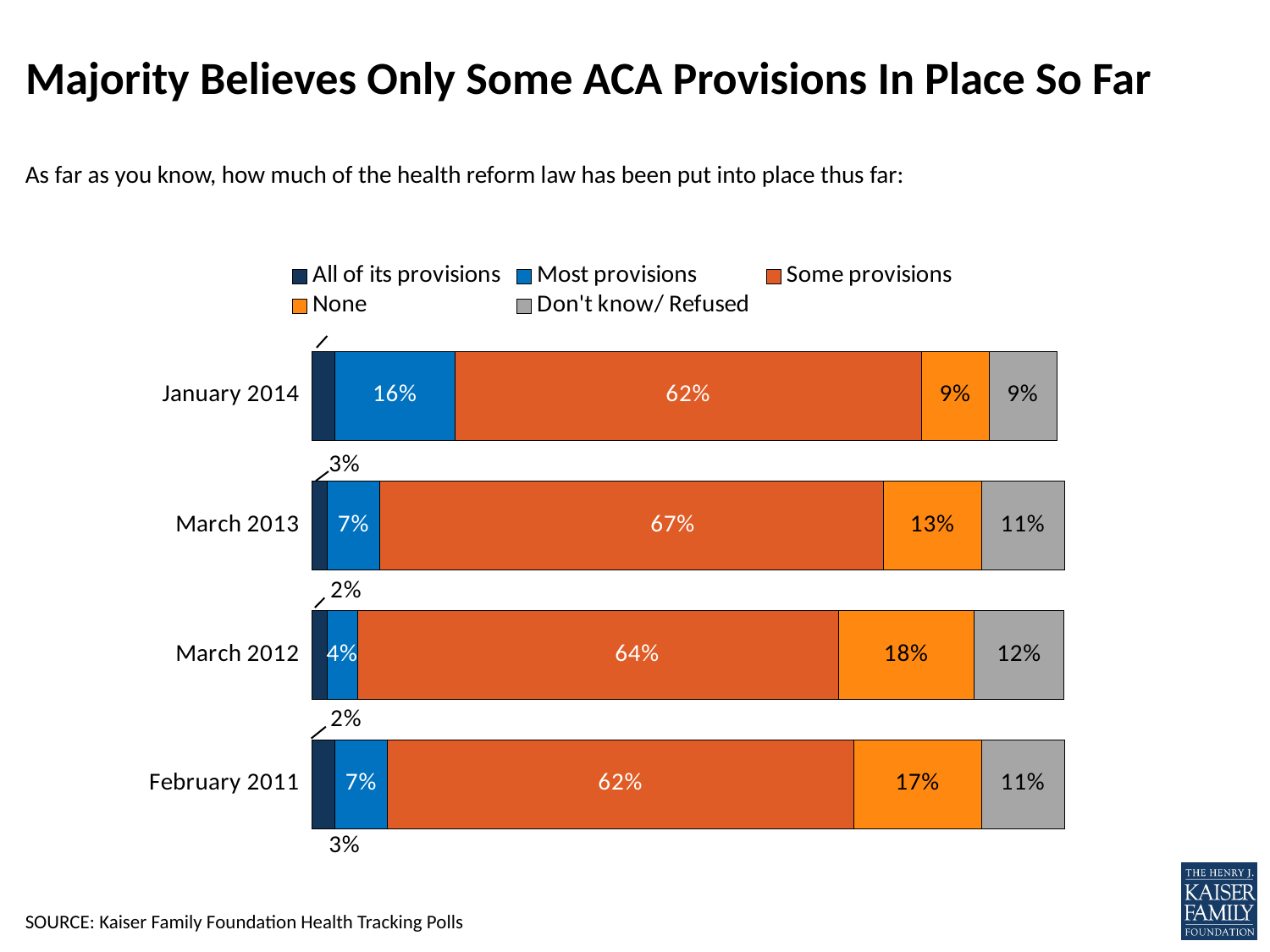
What is the "Don't know/ Refused" value for March 2013? 11% How many survey dates are shown on the chart? 4 What is the title of the slide? Majority Believes Only Some ACA Provisions In Place So Far What percentage said "None" in March 2012? 18% What kind of chart is shown on the slide? Stacked bar chart In which survey date was the "Some provisions" share highest? March 2013 How many series does the legend list? 5 How much larger is the "Most provisions" share in January 2014 than in February 2011? 9 percentage points What percentage said "Most provisions" in January 2014? 16% Which has a larger "None" share, March 2012 or March 2013? March 2012 What percentage said "Some provisions" in January 2014? 62% In which survey date was the "None" share lowest? January 2014